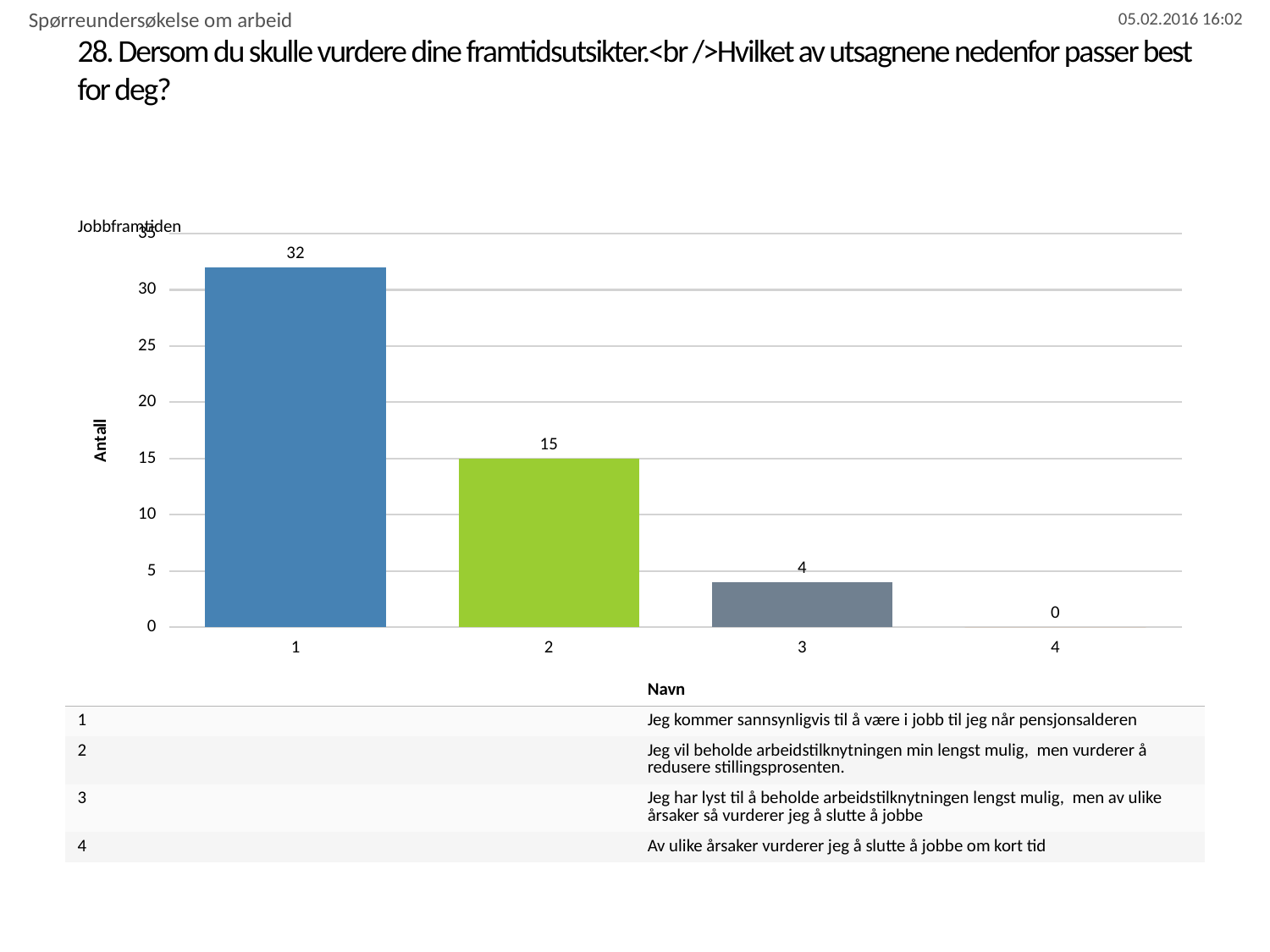
What is the value for category 1? 32 What is the label of the y axis? Antall What is the value for category 2? 15 What is the value for category 4? 0 Which category has the lowest value? 4 What kind of chart is shown on the slide? bar chart Which category has the highest value? 1 Which is larger, the value for category 2 or the value for category 3? 2 What is the difference between the values for category 1 and category 2? 17 What is the value for category 3? 4 How many categories are shown on the x axis? 4 What is the difference between the values for category 2 and category 3? 11